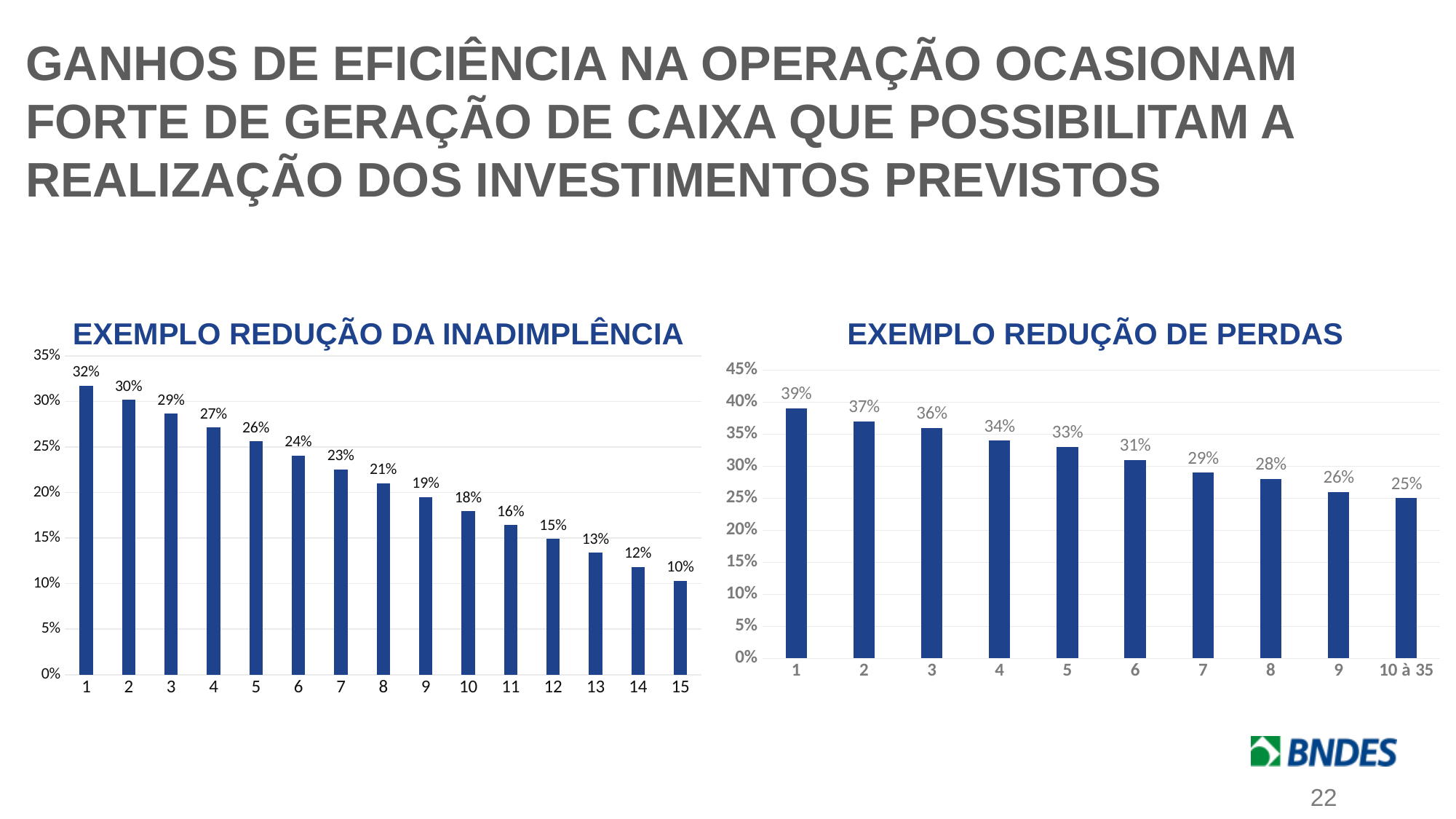
What kind of chart is 'EXEMPLO REDUÇÃO DE PERDAS'? bar chart In the 'EXEMPLO REDUÇÃO DE PERDAS' chart, which category has the highest value? 1 In the 'EXEMPLO REDUÇÃO DE PERDAS' chart, what is the value for the category '10 à 35'? 25% In the 'EXEMPLO REDUÇÃO DE PERDAS' chart, what is the value for category 5? 33% In the 'EXEMPLO REDUÇÃO DA INADIMPLÊNCIA' chart, how many categories are shown on the x axis? 15 In the 'EXEMPLO REDUÇÃO DA INADIMPLÊNCIA' chart, which category has the lowest value? 15 In the 'EXEMPLO REDUÇÃO DA INADIMPLÊNCIA' chart, do the values rise or fall from category 1 to category 15? fall In the 'EXEMPLO REDUÇÃO DA INADIMPLÊNCIA' chart, what is the difference between the values for category 1 and category 15? 22% In the 'EXEMPLO REDUÇÃO DA INADIMPLÊNCIA' chart, what is the value for category 8? 21% In the 'EXEMPLO REDUÇÃO DE PERDAS' chart, how many bars are shown? 10 In the 'EXEMPLO REDUÇÃO DE PERDAS' chart, which is larger, the value for category 3 or category 7? category 3 In the 'EXEMPLO REDUÇÃO DA INADIMPLÊNCIA' chart, what is the value for category 1? 32%